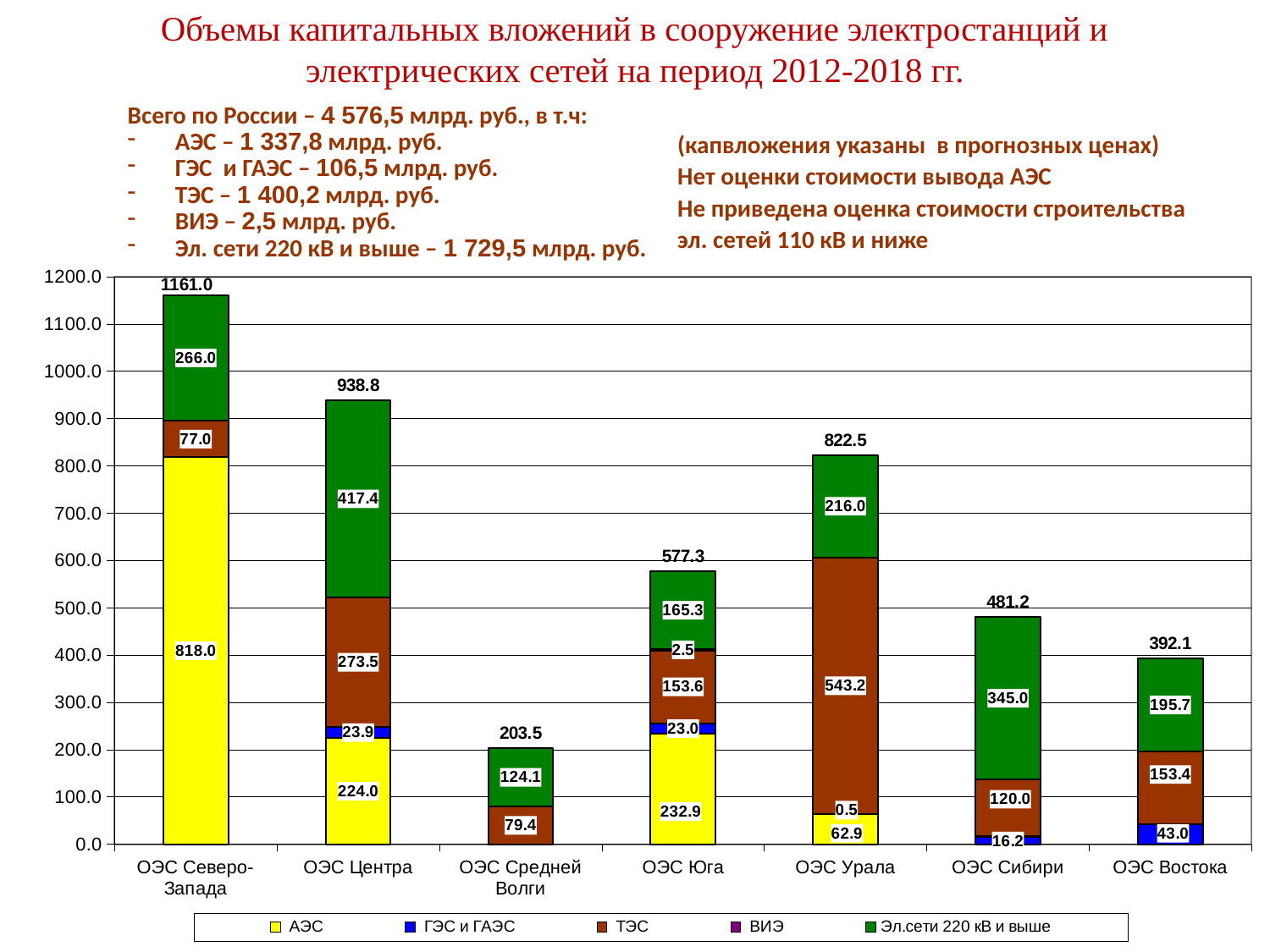
What is the difference between the total for ОЭС Центра and the total for ОЭС Урала? 116.3 What is the value of the АЭС segment for ОЭС Северо-Запада? 818.0 Which region has the highest total bar value? ОЭС Северо-Запада How many categories (ОЭС regions) are shown on the x axis? 7 What type of chart is shown on the slide? Stacked bar chart How many series does the legend list? 5 Which is larger: the ТЭС segment for ОЭС Сибири or the ТЭС segment for ОЭС Востока? ОЭС Востока Which region has the lowest total bar value? ОЭС Средней Волги What is the value of the ВИЭ segment for ОЭС Юга? 2.5 What is the value of the Эл.сети 220 кВ и выше segment for ОЭС Центра? 417.4 What is the value of the ТЭС segment for ОЭС Урала? 543.2 What is the total value of the bar for ОЭС Северо-Запада? 1161.0